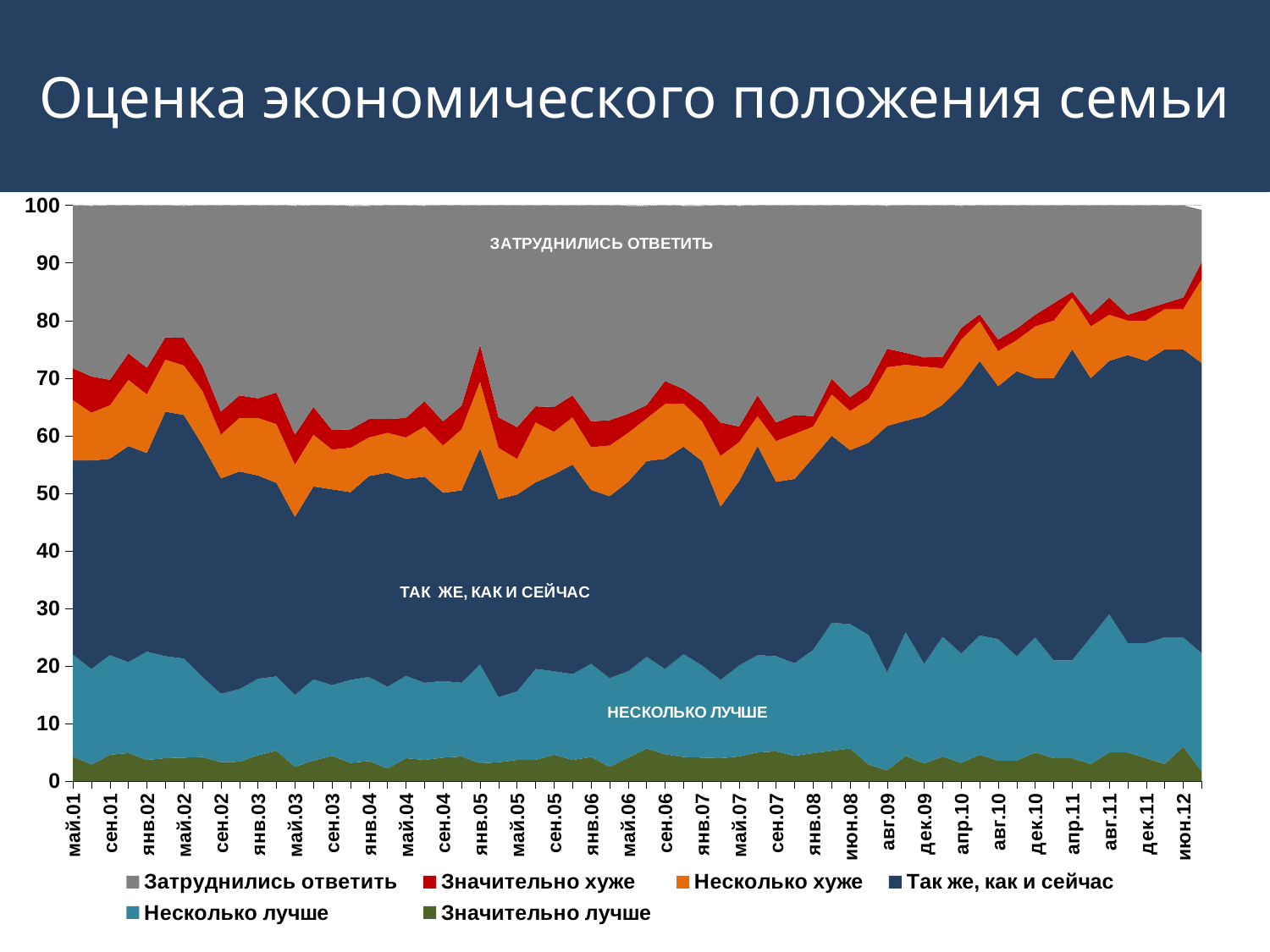
What is the title of the chart? Оценка экономического положения семьи Is the top of the 'Значительно лучше' band at май.01 greater or less than 10? less Is the cumulative top of the 'Так же, как и сейчас' band at май.01 greater or less than 50? greater Which series is drawn in red? Значительно хуже Does the thickness of the 'Так же, как и сейчас' band rise or fall from май.01 to июн.12? Rise Is the cumulative top of the 'Так же, как и сейчас' band at июн.12 greater or less than 60? greater What kind of chart is shown on the slide? Stacked area chart How many series does the legend list? 6 Does the share of 'Затруднились ответить' (the grey area) rise or fall from май.01 to июн.12? Fall